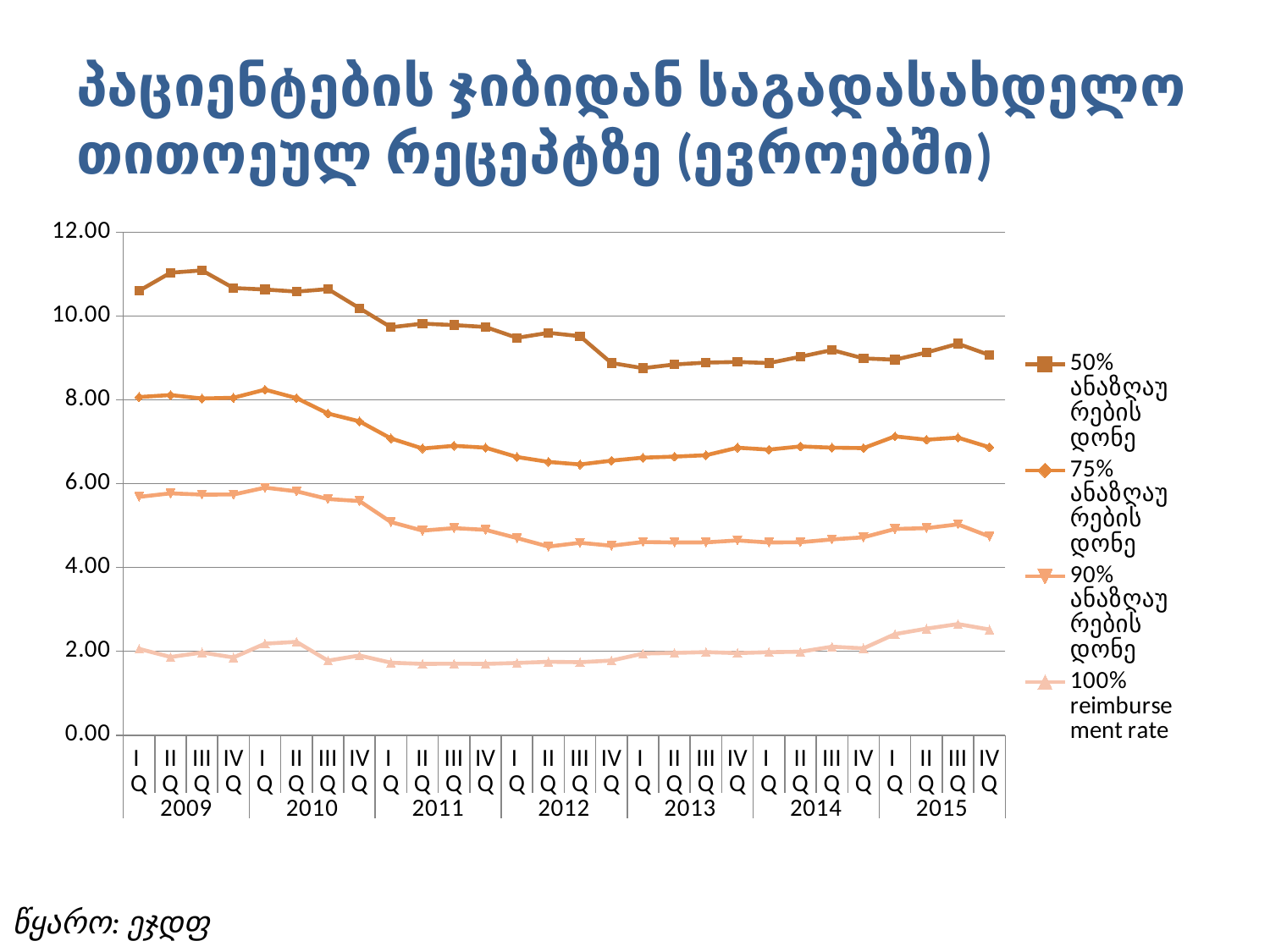
How many series does the legend list? 4 What kind of chart is shown on the slide? line chart How many quarterly data points does each line have? 28 Is the value of the 75% ანაზღაურების დონე series in III Q 2012 greater or less than 6.00? greater Which series has the lowest values throughout the chart? 100% reimbursement rate Which series has the highest values throughout the chart? 50% ანაზღაურების დონე How many years are shown along the x axis? 7 Is the value of the 100% reimbursement rate series in I Q 2011 greater or less than 2.00? less In IV Q 2015, which is larger: the 75% ანაზღაურების დონე series or the 90% ანაზღაურების დონე series? 75% ანაზღაურების დონე Is the value of the 50% ანაზღაურების დონე series in I Q 2009 greater or less than 10.00? greater Does the 50% ანაზღაურების დონე series rise or fall from I Q 2009 to IV Q 2012? fall